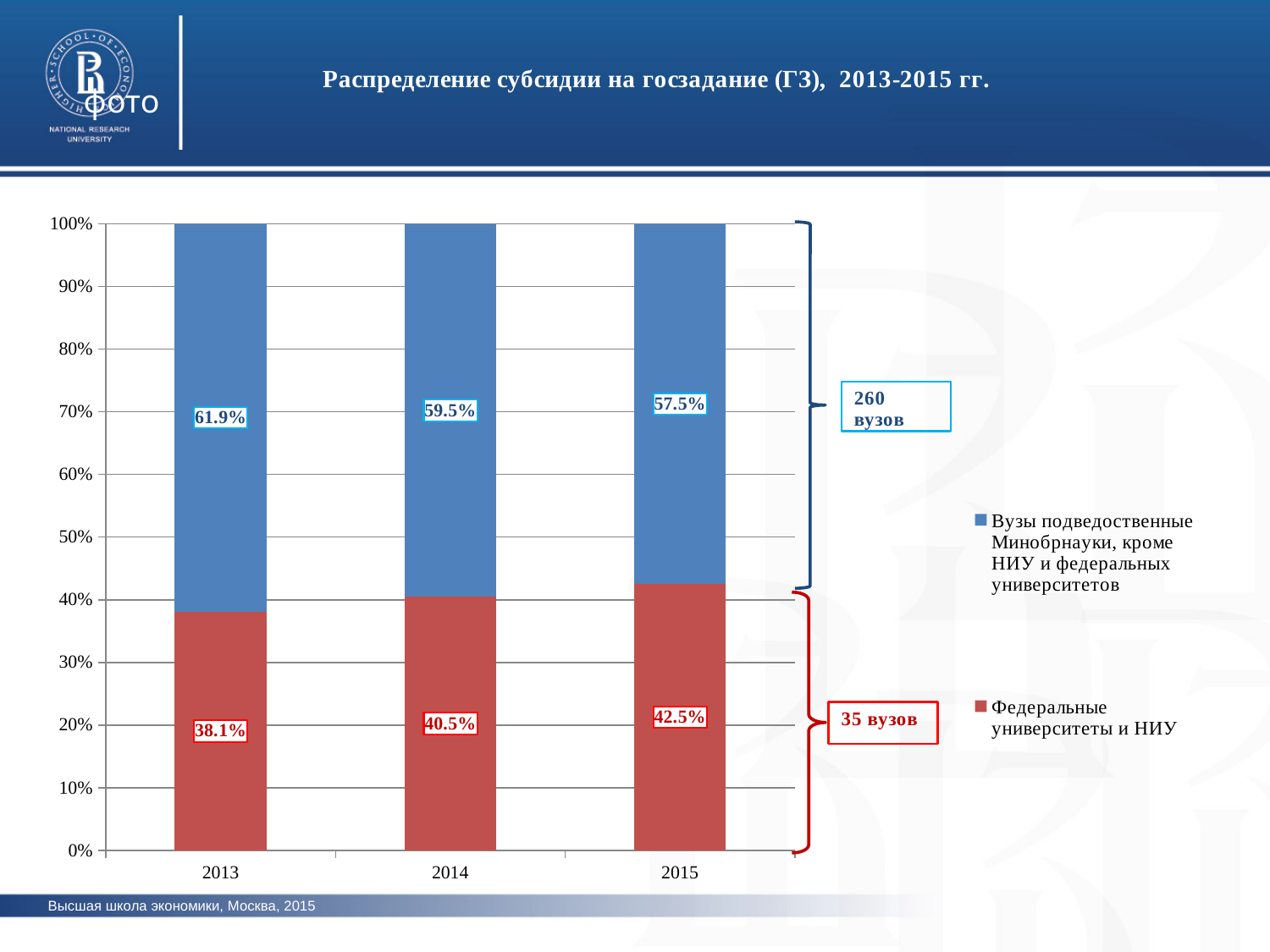
Does the share of Федеральные университеты и НИУ rise or fall from 2013 to 2015? Rise What is the total of the stacked bar for 2014? 100% What is the value for Федеральные университеты и НИУ in 2014? 40.5% Which is larger in 2014: the share of Федеральные университеты и НИУ or the share of Вузы подведоственные Минобрнауки, кроме НИУ и федеральных университетов? Вузы подведоственные Минобрнауки, кроме НИУ и федеральных университетов What is the difference between the Федеральные университеты и НИУ share in 2015 and in 2013? 4.4% What is the value for Вузы подведоственные Минобрнауки, кроме НИУ и федеральных университетов in 2015? 57.5% In which year is the share of Вузы подведоственные Минобрнауки, кроме НИУ и федеральных университетов lowest? 2015 How many years are shown on the x axis? 3 In which year is the share of Федеральные университеты и НИУ highest? 2015 How many series does the legend list? 2 What kind of chart is shown on the slide? Stacked bar chart What is the value for Федеральные университеты и НИУ in 2013? 38.1%